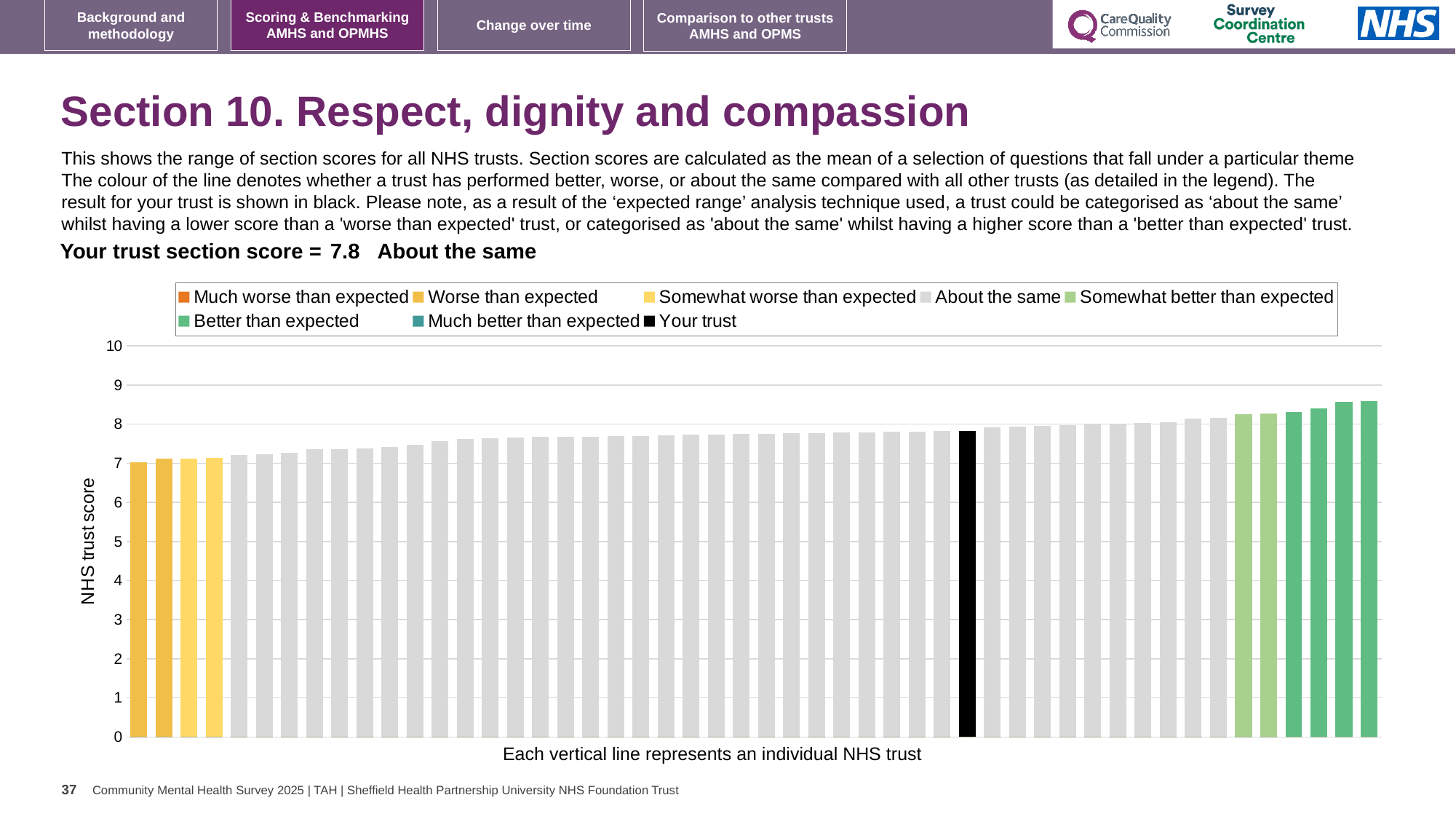
What is the section score for your trust? 7.8 How many entries does the chart legend list? 8 Is the value of the rightmost bar greater or less than 8? greater Which category is your trust placed in for this section? About the same Which is higher, the rightmost bar or the bar for your trust? the rightmost bar What kind of chart is shown on the slide? bar chart Is the value for your trust greater or less than 9? less What colour is the bar representing your trust? black Is the value of the leftmost bar greater or less than 8? less Do the bar values rise or fall from left to right across the chart? rise How many bars are coloured as 'Better than expected'? 4